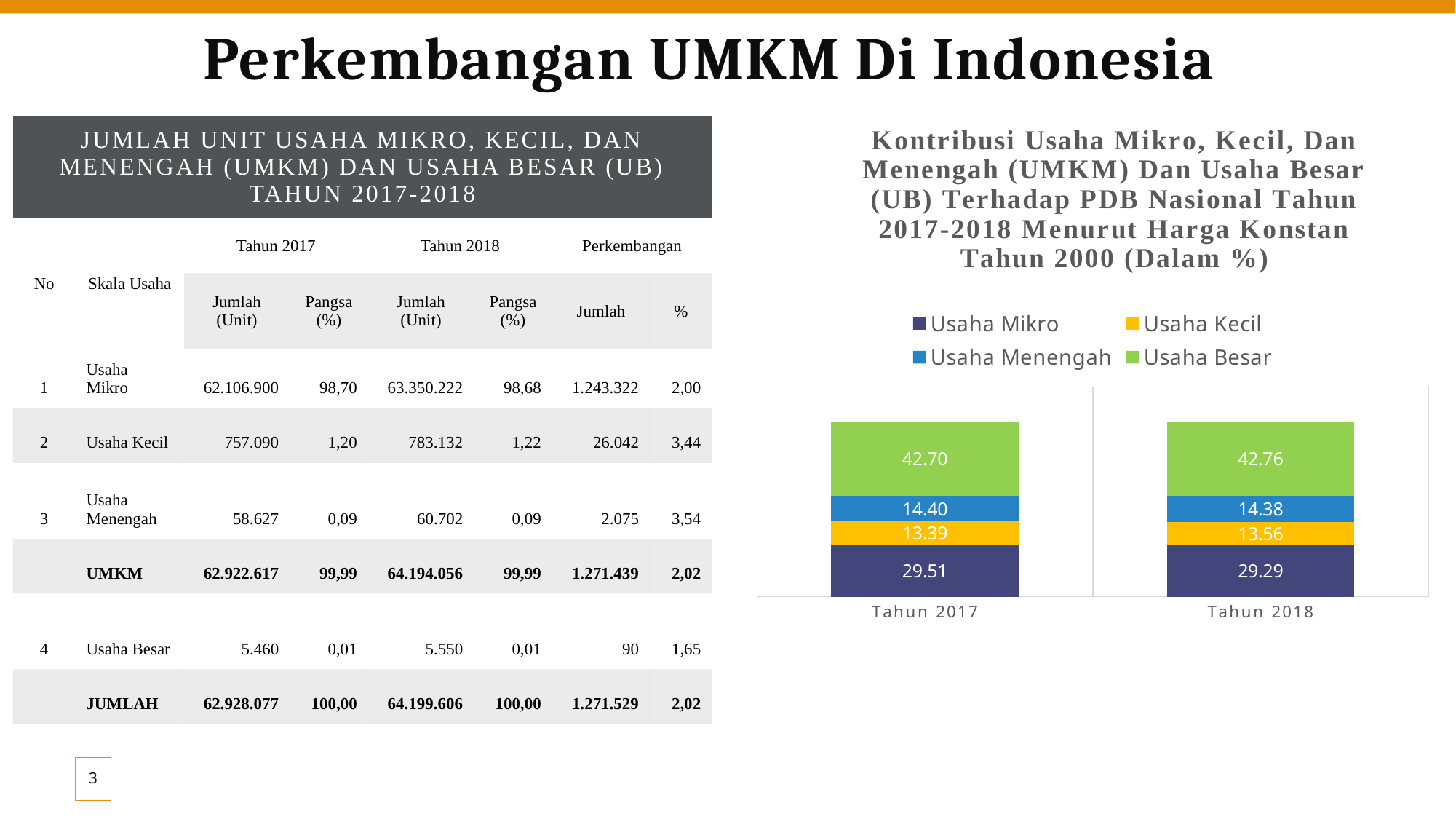
How many categories (years) are shown on the x axis of the chart? 2 How many series does the legend of the chart list? 4 In the chart, what is the value for Usaha Kecil in Tahun 2017? 13.39 In the chart, what is the difference between the Usaha Mikro values for Tahun 2017 and Tahun 2018? 0.22 In the chart, does the value for Usaha Besar rise or fall from Tahun 2017 to Tahun 2018? Rise In the chart, which series has the largest segment in Tahun 2018? Usaha Besar In the chart, which is larger in Tahun 2018: Usaha Menengah or Usaha Kecil? Usaha Menengah In the chart, what is the total of the stacked bar for Tahun 2017? 100.00 In the chart, what is the value for Usaha Besar in Tahun 2017? 42.70 In the chart, what is the value for Usaha Mikro in Tahun 2018? 29.29 In the chart, which series has the smallest segment in Tahun 2017? Usaha Kecil What kind of chart is shown on the right side of the slide? Stacked bar chart